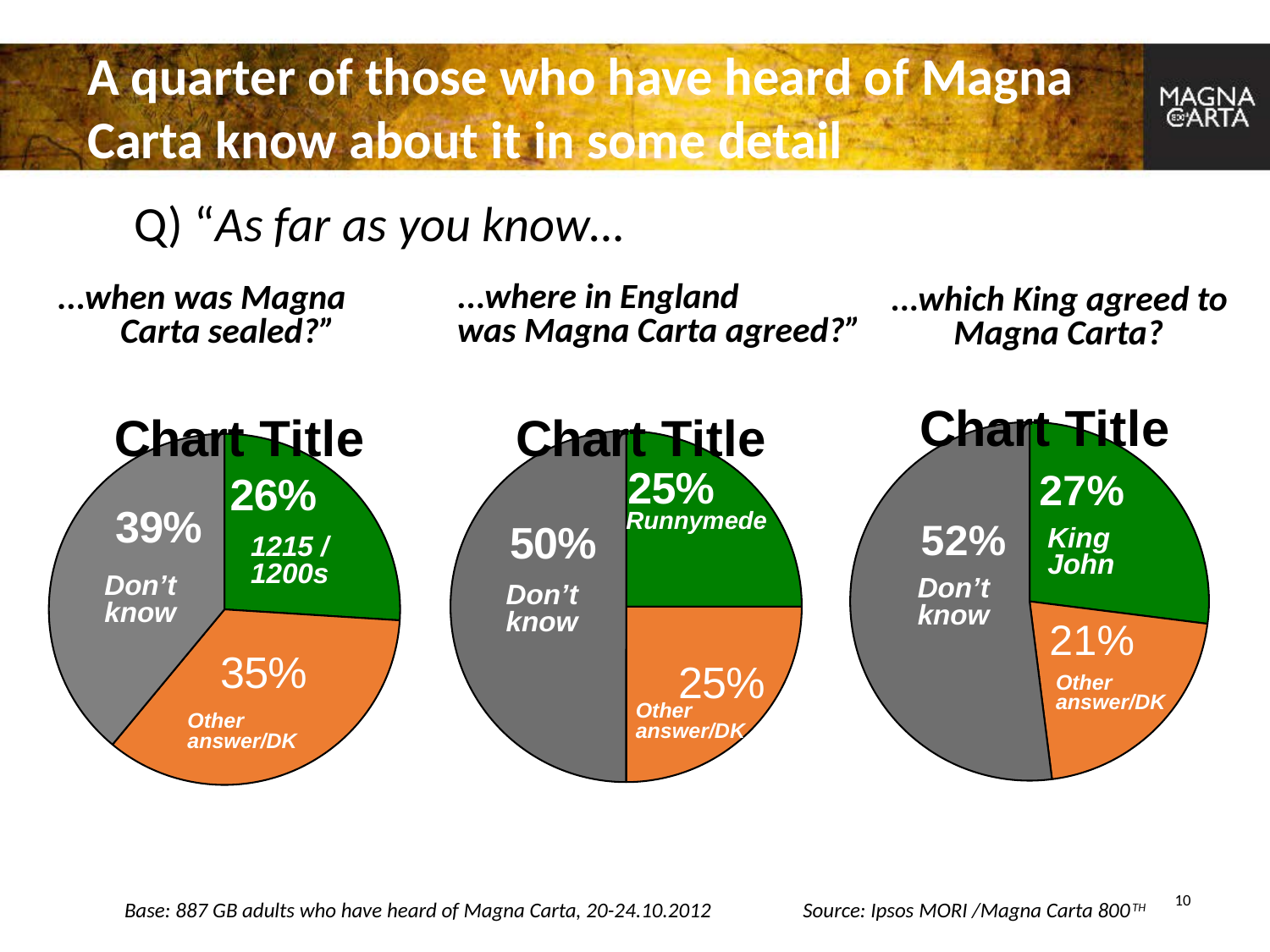
In the right pie chart (which King agreed to Magna Carta?), what share of respondents answered King John? 27% In the right pie chart (which King agreed to Magna Carta?), what is the difference between the Don't know share and the King John share? 25% How many slices does the middle pie chart (where in England was Magna Carta agreed?) have? 3 In the middle pie chart (where in England was Magna Carta agreed?), what share of respondents said Don't know? 50% In the left pie chart (when was Magna Carta sealed?), which is larger: the Other answer/DK slice or the 1215 / 1200s slice? Other answer/DK In the right pie chart (which King agreed to Magna Carta?), what share gave Other answer/DK? 21% In the left pie chart (when was Magna Carta sealed?), what share of respondents said Don't know? 39% In the left pie chart (when was Magna Carta sealed?), what share of respondents answered 1215 / 1200s? 26% What type of chart is used for the three charts on the slide? Pie chart In the right pie chart (which King agreed to Magna Carta?), which slice is the largest? Don't know In the middle pie chart (where in England was Magna Carta agreed?), what share of respondents answered Runnymede? 25% In the left pie chart (when was Magna Carta sealed?), which slice is the smallest? 1215 / 1200s